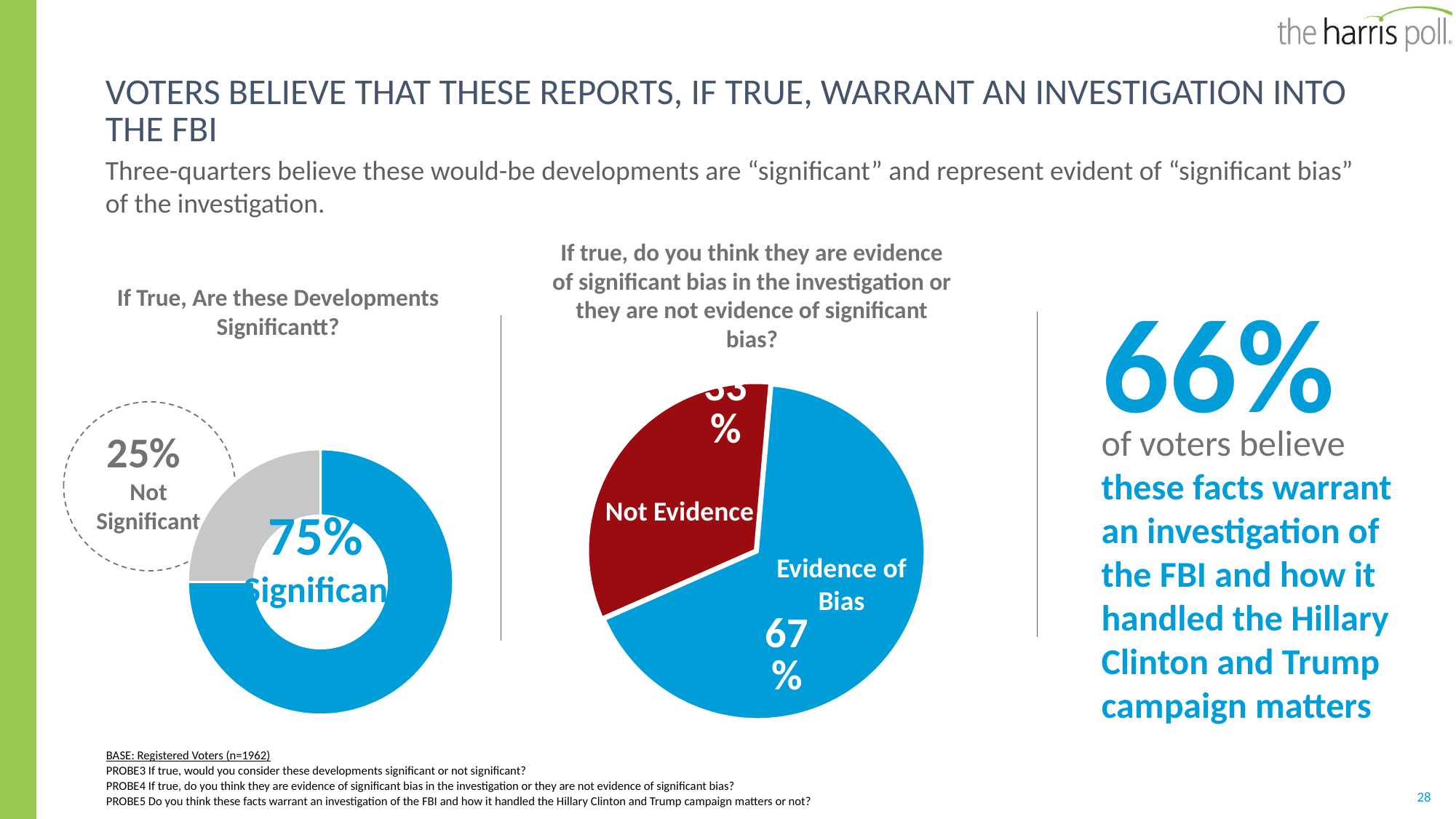
In the pie chart in the middle of the slide, what colour is the Not Evidence slice? Dark red In the pie chart in the middle of the slide, what percentage of voters said the developments are Evidence of Bias? 67% In the pie chart in the middle of the slide, which slice is the largest? Evidence of Bias What type of chart is the chart on the left of the slide? Donut chart How many categories does the donut chart on the left show? 2 In the donut chart titled "If True, Are these Developments Significant?", what percentage of voters said Not Significant? 25% According to the large callout on the right of the slide, what percentage of voters believe these facts warrant an investigation of the FBI? 66% In the donut chart titled "If True, Are these Developments Significant?", what percentage of voters said the developments are Significant? 75% In the donut chart on the left, which category has the larger share: Significant or Not Significant? Significant How many slices does the pie chart in the middle of the slide have? 2 In the pie chart in the middle of the slide, which slice is the smallest? Not Evidence In the donut chart on the left, what is the difference in percentage points between Significant and Not Significant? 50 percentage points